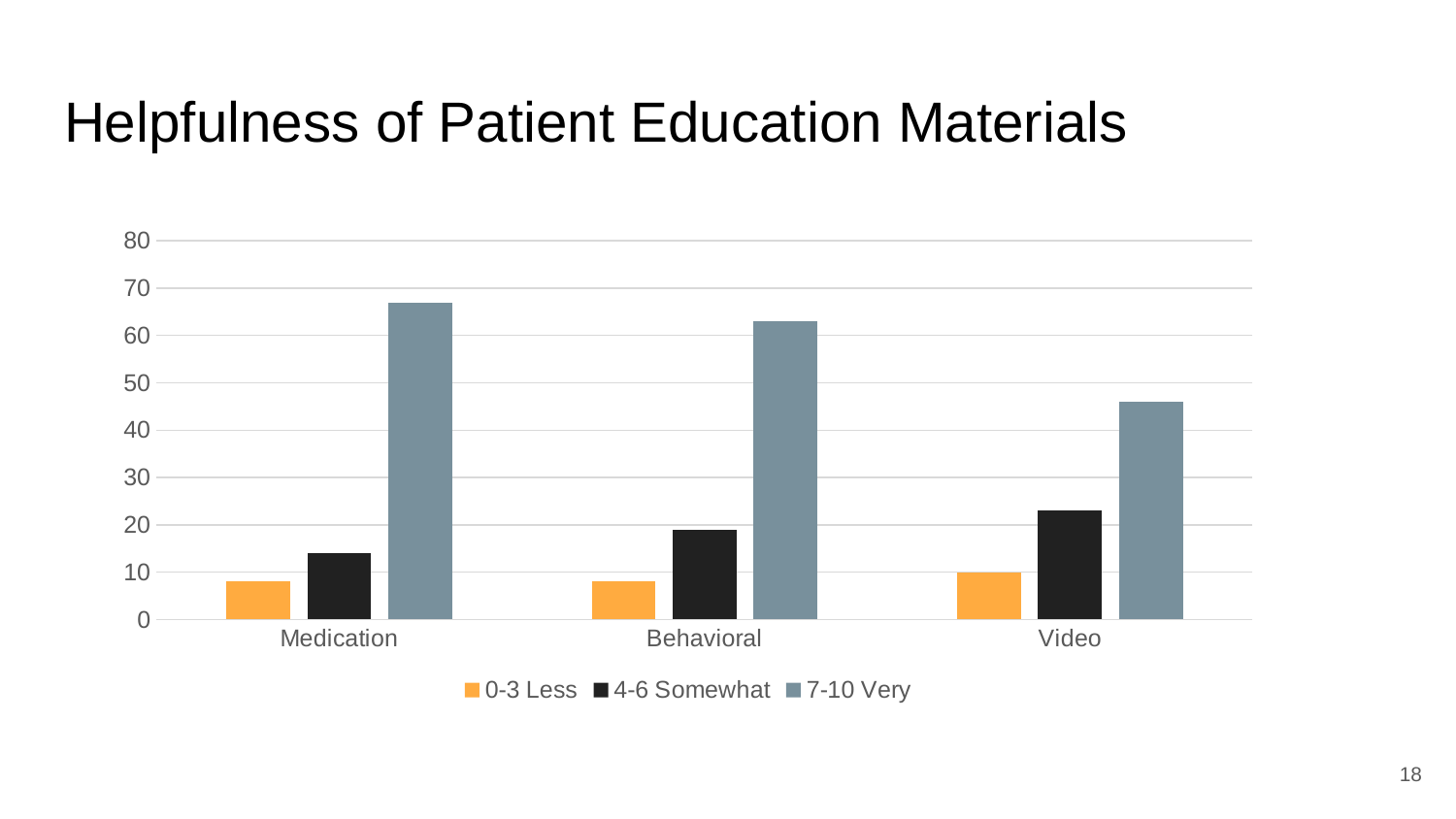
Which category has the highest value for the 7-10 Very series? Medication Which is larger: the 4-6 Somewhat value for Medication or the 4-6 Somewhat value for Video? Video What kind of chart is shown on the slide? bar chart How many categories are shown on the x axis? 3 Which category has the lowest value for the 7-10 Very series? Video Which is larger: the 7-10 Very value for Behavioral or the 7-10 Very value for Video? Behavioral Is the value for 7-10 Very in Medication greater or less than 60? greater Is the value for 7-10 Very in Video greater or less than 50? less How many series does the legend list? 3 What is the title of the chart on the slide? Helpfulness of Patient Education Materials Which category has the highest value for the 4-6 Somewhat series? Video